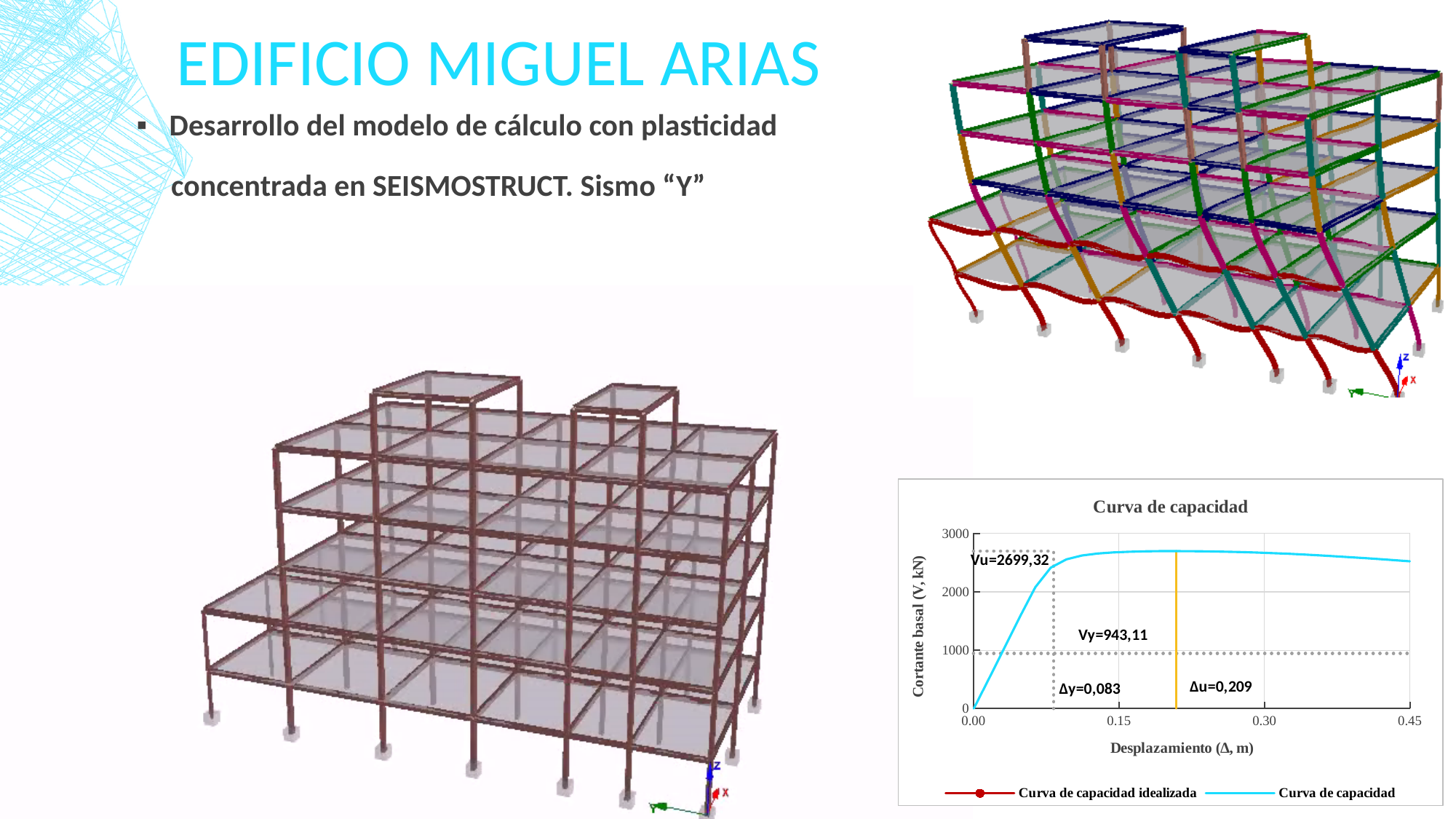
What value of Vu is labelled on the 'Curva de capacidad' chart? 2699,32 On the 'Curva de capacidad' chart, is the base shear at a displacement of 0.30 m greater or less than 2000 kN? greater What value of Δu is labelled on the 'Curva de capacidad' chart? 0,209 What value of Vy is labelled on the 'Curva de capacidad' chart? 943,11 What type of chart is the 'Curva de capacidad' chart? line chart How many series does the legend of the 'Curva de capacidad' chart list? 2 On the 'Curva de capacidad' chart, what is the difference between Vu and Vy? 1756,21 What value of Δy is labelled on the 'Curva de capacidad' chart? 0,083 What is the label of the x axis on the 'Curva de capacidad' chart? Desplazamiento (Δ, m) What is the title of the chart on the slide? Curva de capacidad On the 'Curva de capacidad' chart, which is larger, Vu or Vy? Vu On the 'Curva de capacidad' chart, what is the difference between Δu and Δy? 0,126